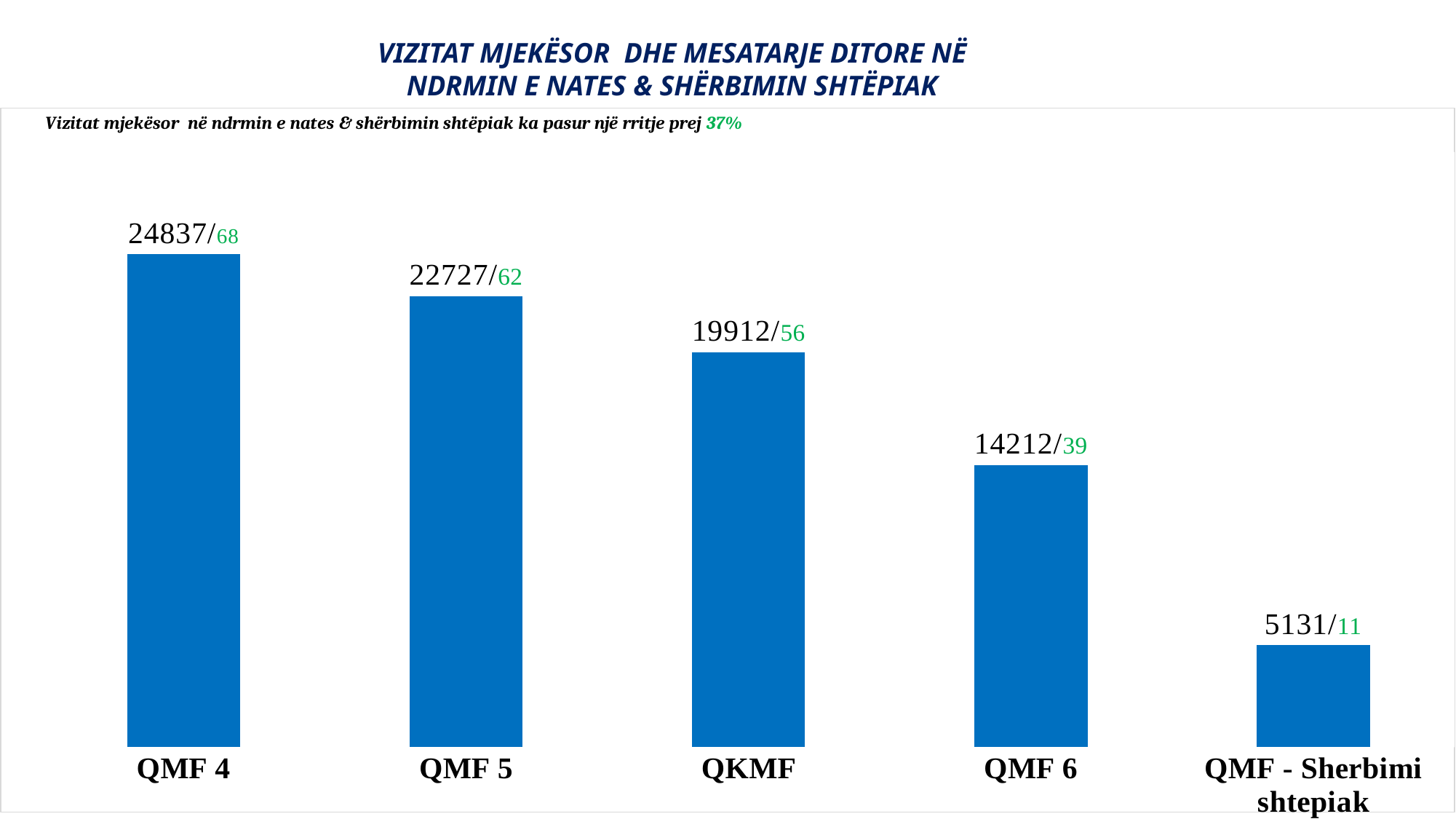
Which category has the highest number of visits? QMF 4 What is the daily average (the green number) shown for QMF 5? 62 Which has more visits, QMF 6 or QKMF? QKMF What is the daily average shown for QMF - Sherbimi shtepiak? 11 What is the number of visits shown for QKMF? 19912 What is the number of medical visits shown for QMF 4? 24837 What is the difference in visits between QMF 4 and QMF 5? 2110 Which category has the lowest number of visits? QMF - Sherbimi shtepiak What is the difference in visits between QKMF and QMF 6? 5700 What kind of chart is shown on the slide? Bar chart Do the bar values rise or fall from left to right across the chart? Fall How many categories are shown on the chart? 5